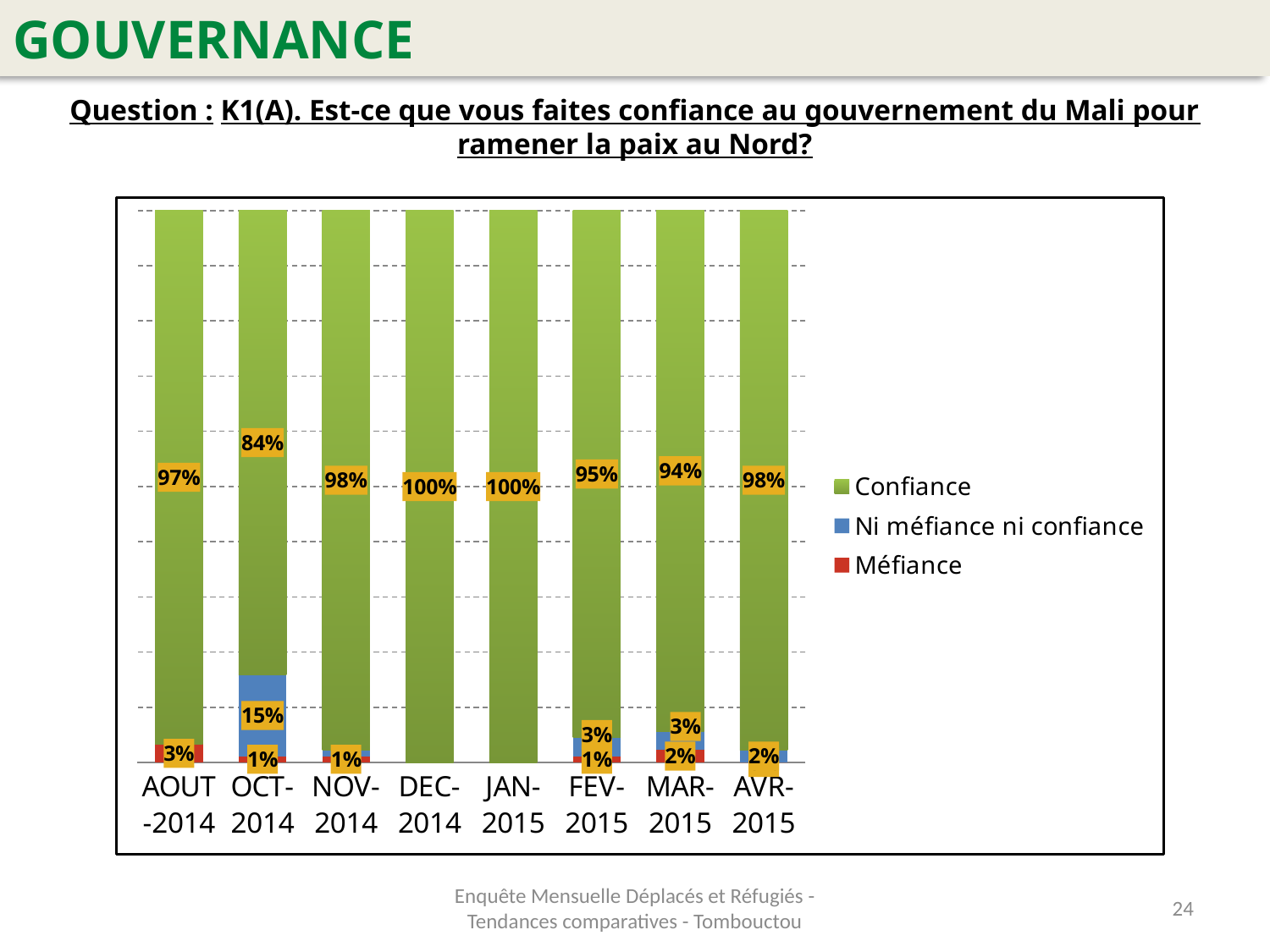
What is the Confiance value for OCT-2014? 84% Which month has the lowest Confiance value? OCT-2014 How many months are shown on the x axis? 8 What is the Ni méfiance ni confiance value for OCT-2014? 15% What is the Confiance value for MAR-2015? 94% What kind of chart is shown on the slide? Stacked bar chart Which has a higher Confiance value, FEV-2015 or MAR-2015? FEV-2015 What is the Méfiance value for AOUT-2014? 3% What is the Confiance value for AOUT-2014? 97% How many series does the legend list? 3 Which month has the highest Ni méfiance ni confiance value? OCT-2014 What is the difference between the Confiance values for AOUT-2014 and OCT-2014? 13 percentage points